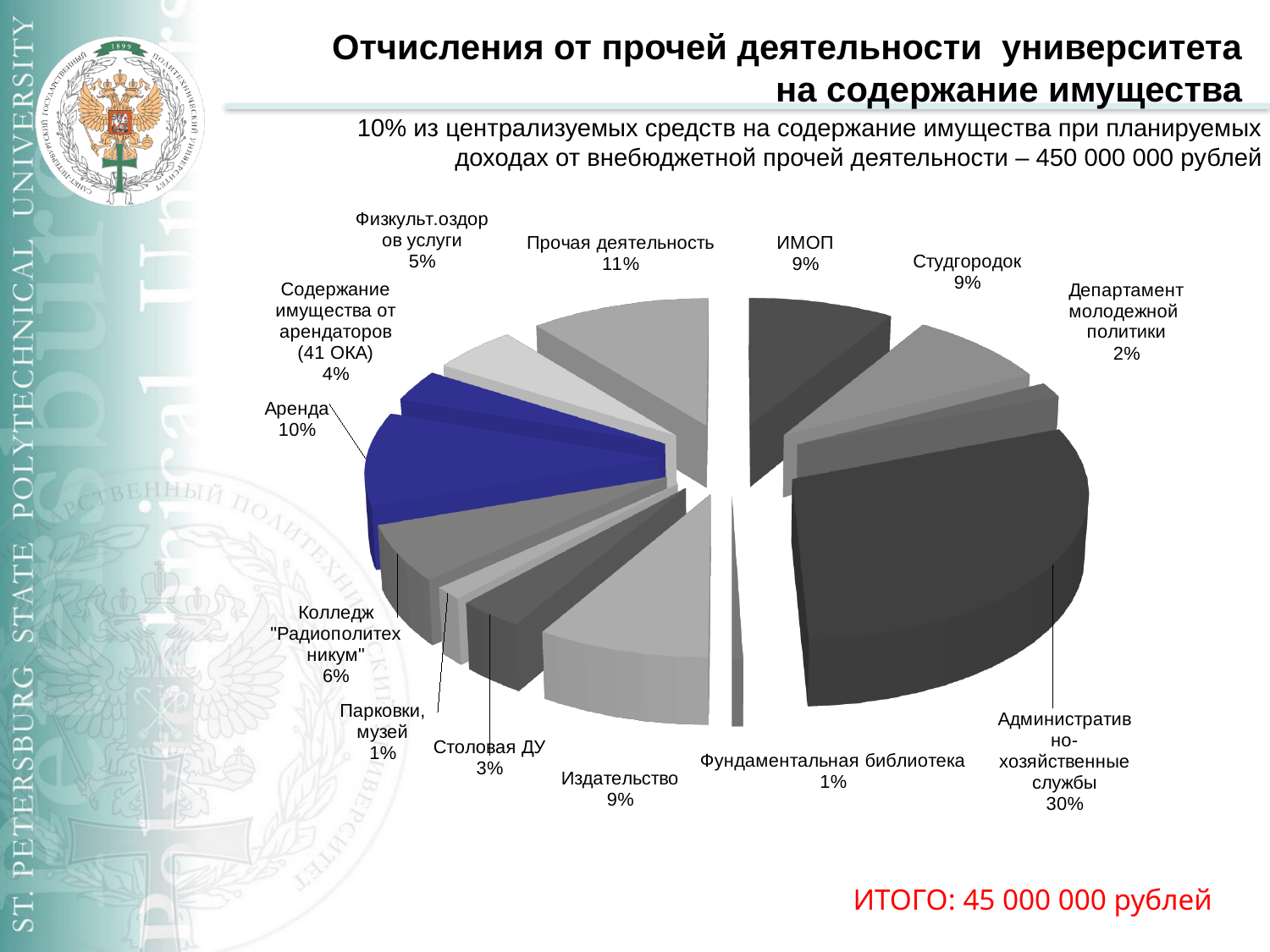
How many categories are shown in the pie chart? 13 Which category has the largest share of the pie? Административно-хозяйственные службы What is the value for Департамент молодежной политики? 2% What total amount in rubles is stated below the chart (ИТОГО)? 45 000 000 рублей What kind of chart is shown on the slide? pie chart What is the difference between the shares of Прочая деятельность and Столовая ДУ? 8% What share of the pie does Административно-хозяйственные службы have? 30% Which is larger, the share for Физкульт.оздоров услуги or the share for Содержание имущества от арендаторов (41 ОКА)? Физкульт.оздоров услуги What is the difference between the shares of Административно-хозяйственные службы and Аренда? 20% What is the value for Колледж "Радиополитехникум"? 6% What is the value for Аренда? 10% What is the value for Прочая деятельность? 11%